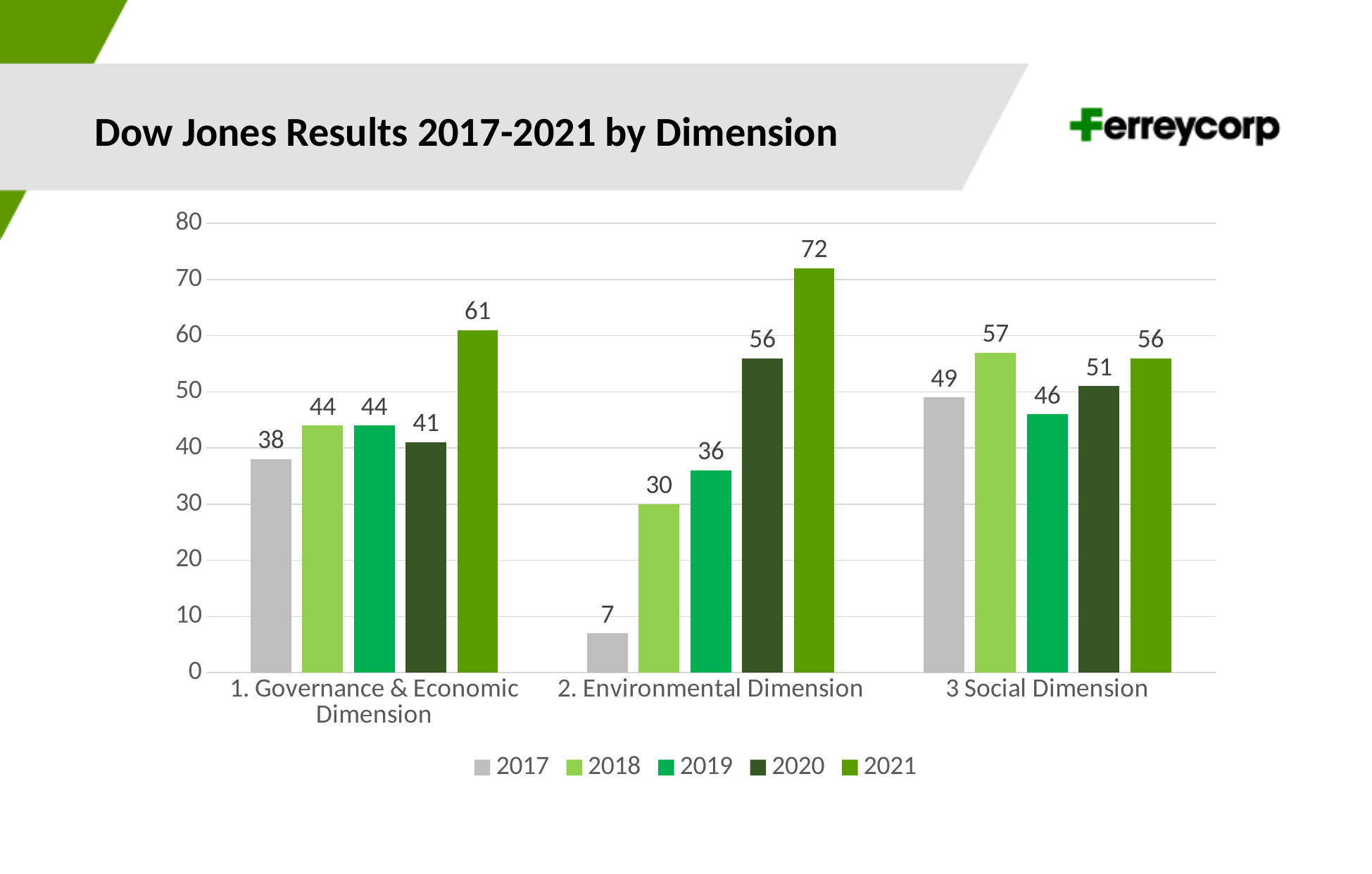
What is the 2021 value for the Environmental Dimension? 72 What is the difference between the 2021 and 2017 values for the Environmental Dimension? 65 How many dimension categories are shown on the x axis? 3 What is the difference between the 2021 and 2020 values for the Governance & Economic Dimension? 20 Which year has the highest value in the Governance & Economic Dimension? 2021 What is the 2019 value for the Social Dimension? 46 What kind of chart is shown on the slide? Bar chart How many series does the legend list? 5 Which year has the lowest value in the Environmental Dimension? 2017 What is the title of the chart on the slide? Dow Jones Results 2017-2021 by Dimension What is the 2017 value for the Governance & Economic Dimension? 38 Which is larger: the 2018 value for the Social Dimension or the 2018 value for the Environmental Dimension? Social Dimension